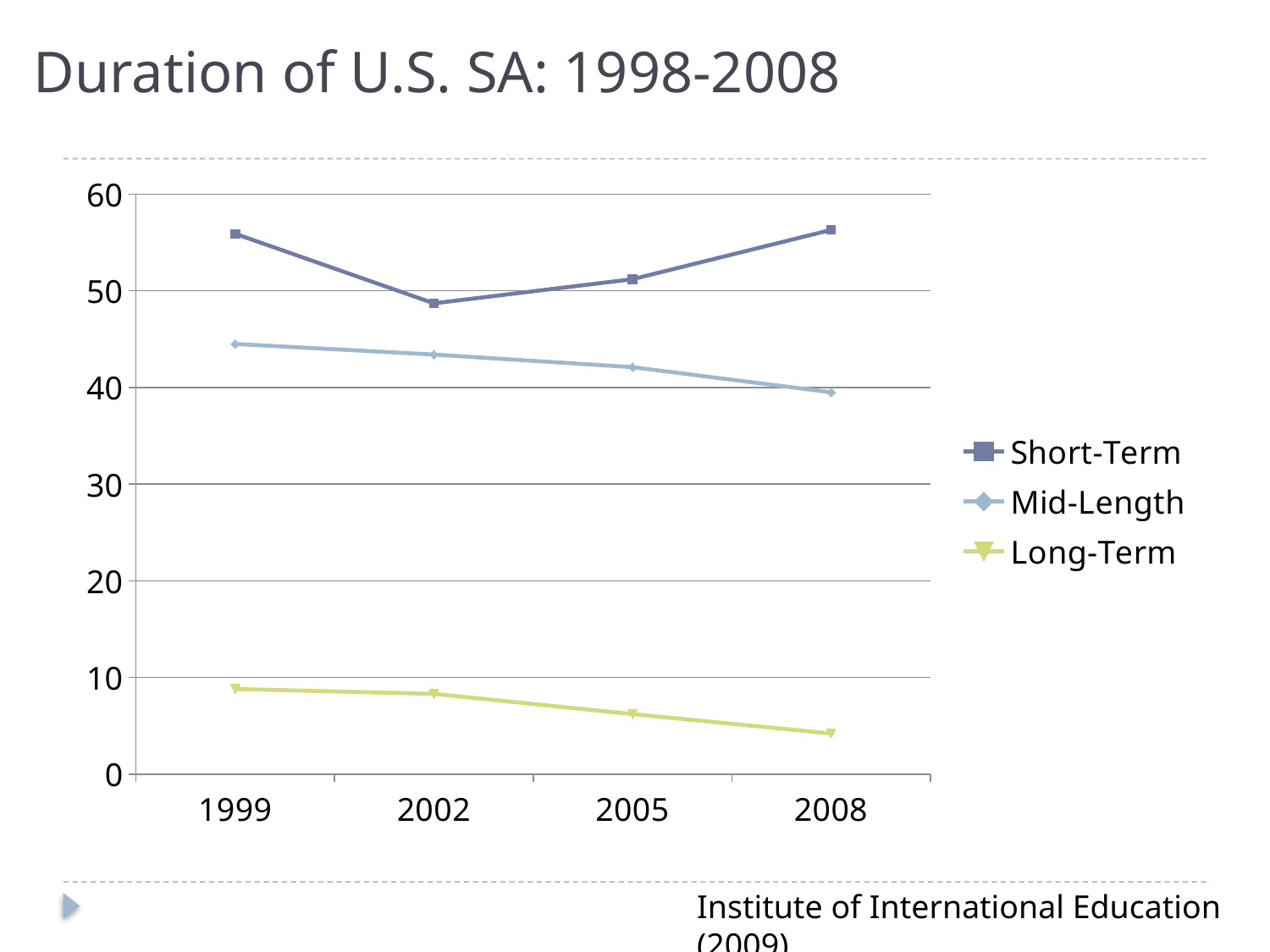
Is the Short-Term value for 2002 greater or less than 50? less What kind of chart is shown on the slide? line chart What is the title of the slide? Duration of U.S. SA: 1998-2008 In which year is the Short-Term series at its lowest? 2002 Does the Mid-Length series rise or fall from 1999 to 2008? fall Is the Short-Term value for 1999 greater or less than 50? greater In which year is the Mid-Length series at its lowest? 2008 Is the Long-Term value for 2008 greater or less than 10? less How many series does the legend list? 3 In 2002, which is larger: the Short-Term value or the Mid-Length value? Short-Term How many years are plotted along the x axis? 4